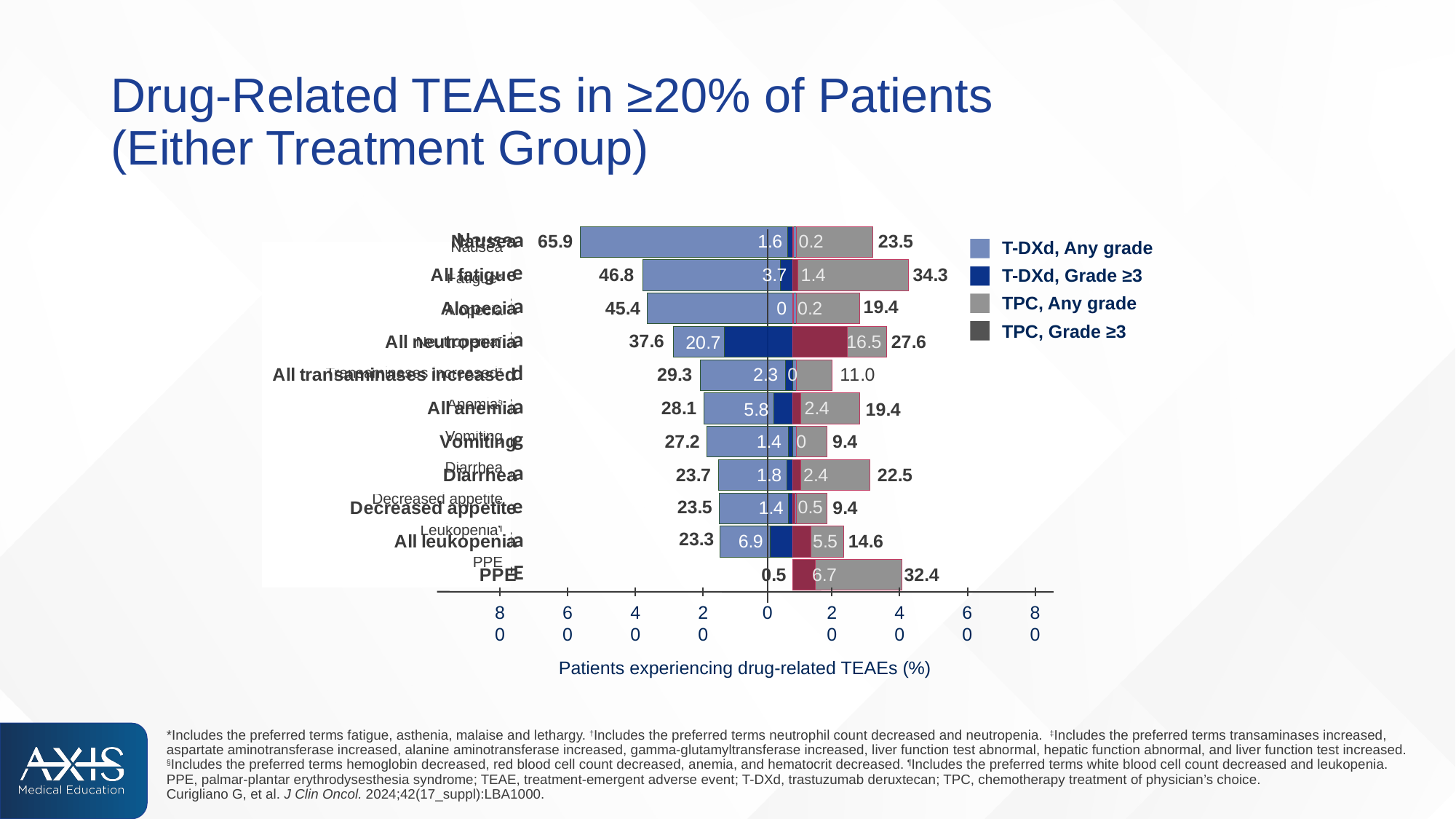
What is the label of the x axis? Patients experiencing drug-related TEAEs (%) What is the TPC, Grade ≥3 value for PPE? 6.7 What is the T-DXd, Grade ≥3 value for All neutropenia? 20.7 Which category has the lowest T-DXd, Any grade value? PPE Which category has the highest T-DXd, Any grade value? Nausea What is the TPC, Any grade value for All fatigue? 34.3 What is the T-DXd, Any grade value for Nausea? 65.9 What type of chart is shown on the slide? bar chart How many adverse event categories are plotted on the chart? 11 How many series does the legend list? 4 What is the difference between the T-DXd, Any grade and TPC, Any grade values for Nausea? 42.4 Which is larger for Diarrhea: the T-DXd, Any grade value or the TPC, Any grade value? T-DXd, Any grade